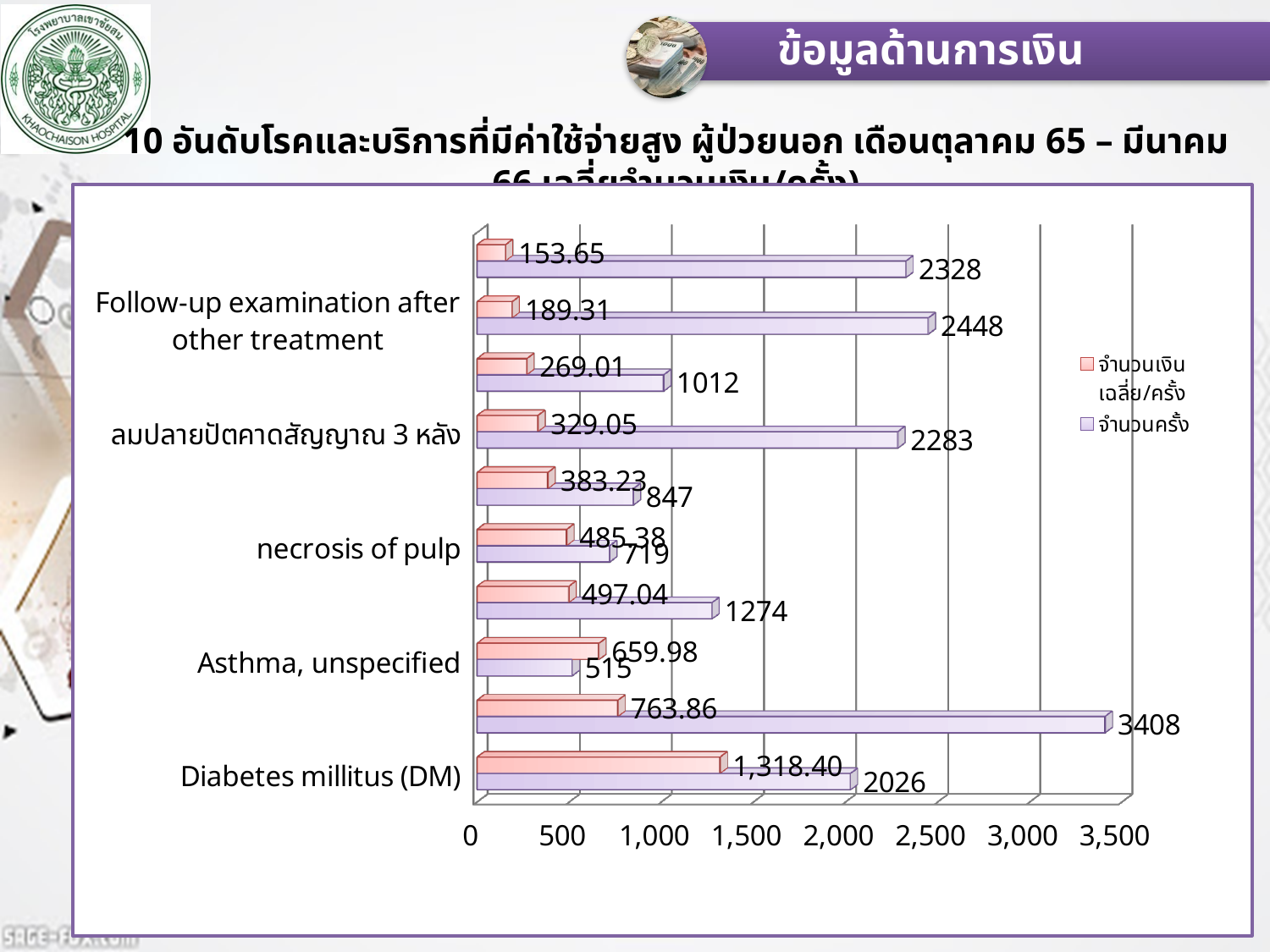
How many series does the legend list? 2 Which has a larger จำนวนครั้ง value, necrosis of pulp or Asthma, unspecified? necrosis of pulp What is the difference in จำนวนครั้ง between Follow-up examination after other treatment and Diabetes millitus (DM)? 422 Which category has the lowest จำนวนครั้ง value? Asthma, unspecified What kind of chart is shown on the slide? bar chart What is the จำนวนเงินเฉลี่ย/ครั้ง value for necrosis of pulp? 485.38 What is the จำนวนครั้ง value for ลมปลายปัตคาดสัญญาณ 3 หลัง? 2283 Which category has the highest จำนวนเงินเฉลี่ย/ครั้ง value? Diabetes millitus (DM) What is the จำนวนเงินเฉลี่ย/ครั้ง value for Asthma, unspecified? 659.98 How many categories are plotted in the chart? 10 What is the จำนวนครั้ง value for Diabetes millitus (DM)? 2026 What is the จำนวนครั้ง value for Follow-up examination after other treatment? 2448